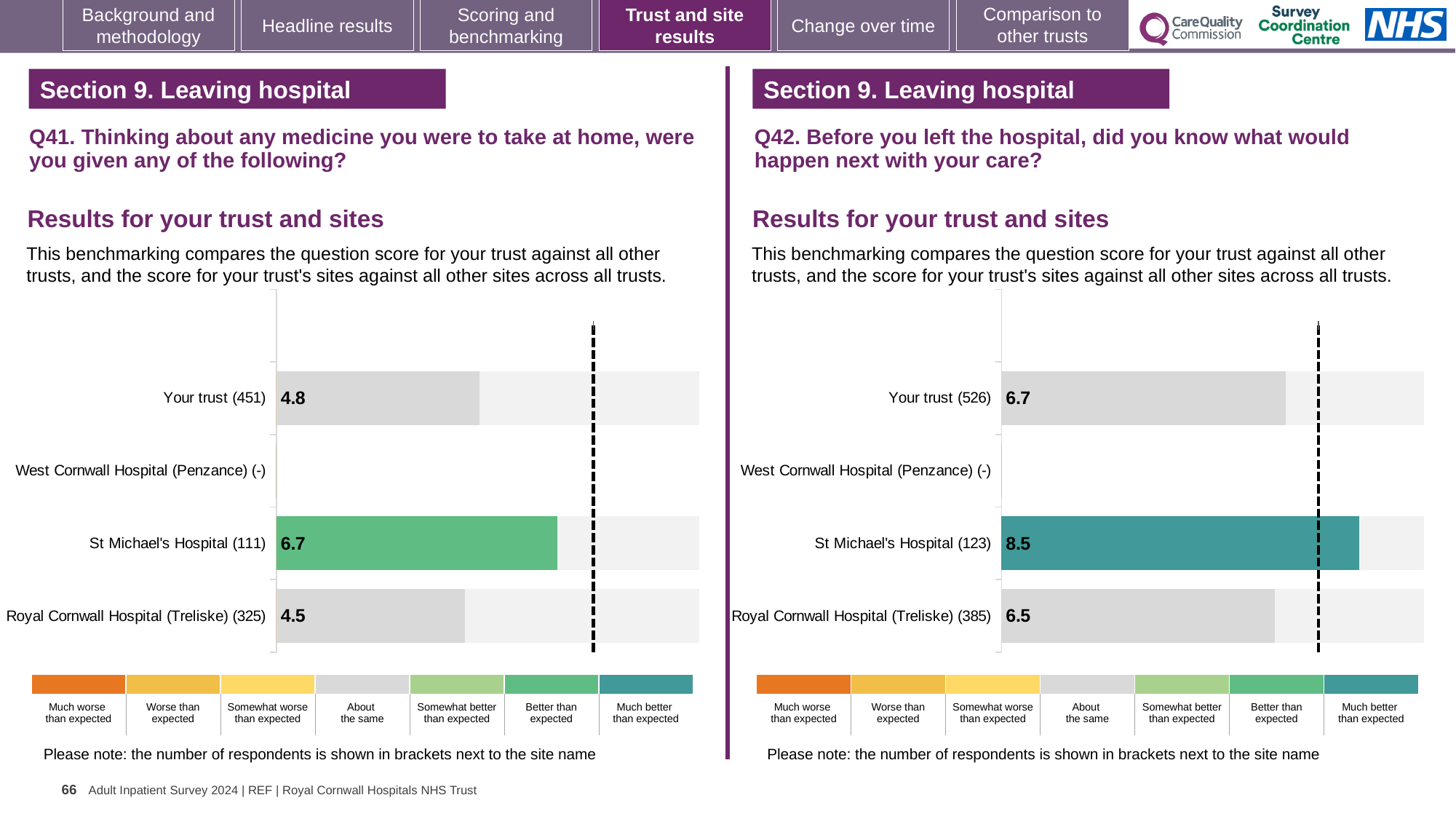
In the Q42 chart on the right, what is the score for St Michael's Hospital? 8.5 In the Q41 chart on the left, which benchmark category does the colour of the St Michael's Hospital bar correspond to? Better than expected What type of chart is used for the Q41 results on the left? Bar chart In the Q41 chart on the left, what is the score for Royal Cornwall Hospital (Treliske)? 4.5 In the Q41 chart on the left, which site or trust has the lowest score? Royal Cornwall Hospital (Treliske) In the Q42 chart on the right, how many respondents are shown in brackets for Your trust? 526 In the Q42 chart on the right, which site or trust has the highest score? St Michael's Hospital In the Q42 chart on the right, what is the score for Royal Cornwall Hospital (Treliske)? 6.5 In the Q42 chart on the right, what is the difference between the scores for St Michael's Hospital and Royal Cornwall Hospital (Treliske)? 2.0 In the Q41 chart on the left, what is the score for Your trust? 4.8 In the Q41 chart on the left, what is the score for St Michael's Hospital? 6.7 In the Q41 chart on the left, which has the larger score: Your trust or Royal Cornwall Hospital (Treliske)? Your trust